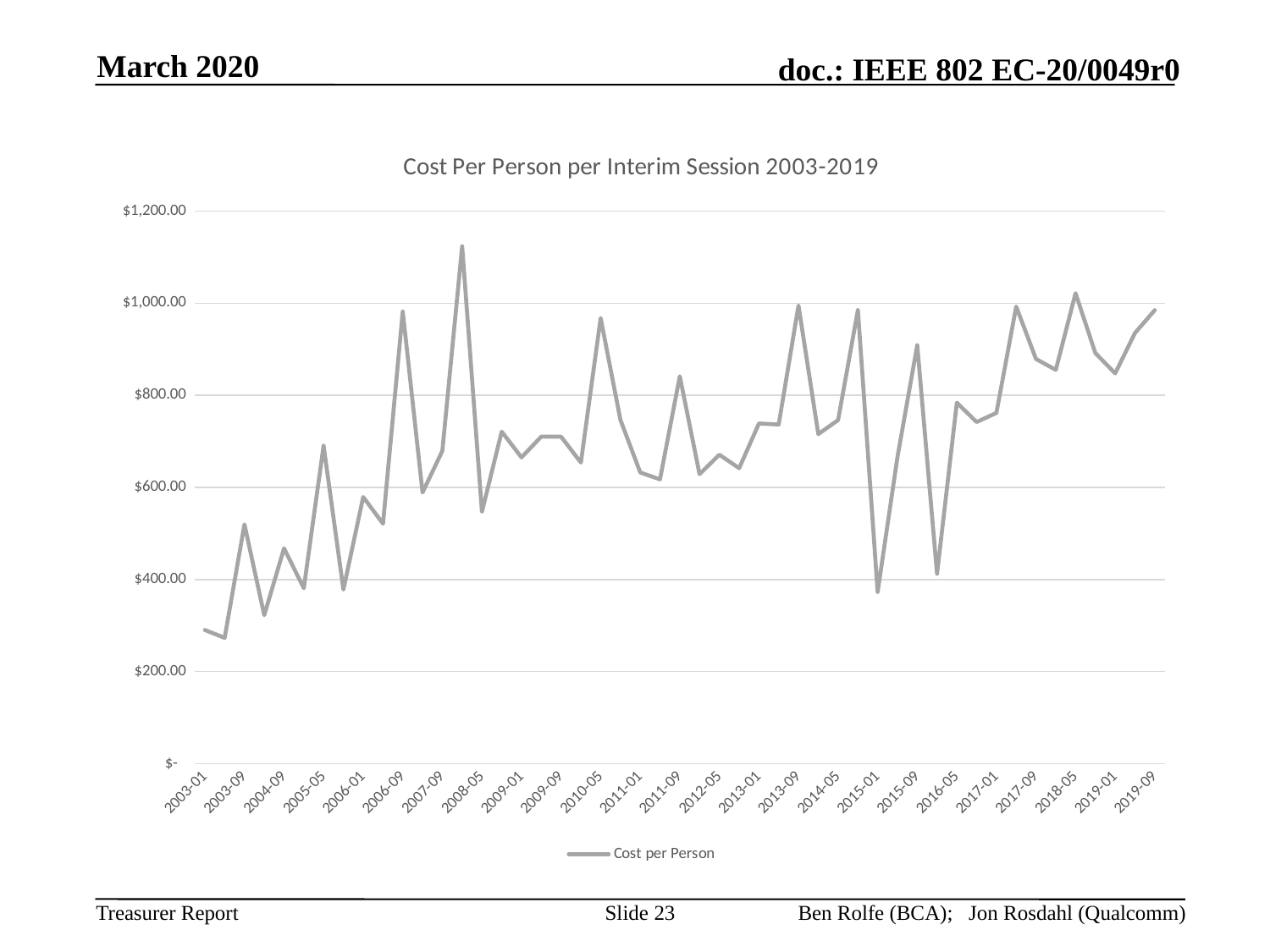
Overall, does the cost per person rise or fall from 2003-01 to 2019-09? rise How many series does the legend list? 1 Is the value for 2013-09 greater or less than $800.00? greater What kind of chart is shown on the slide? line chart Is the value for 2006-09 greater or less than $800.00? greater Is the value for 2003-01 greater or less than $400.00? less What is the title of the chart? Cost Per Person per Interim Session 2003-2019 What is the name of the series shown in the legend? Cost per Person Which is larger, the value for 2008-05 or the value for 2003-09? 2008-05